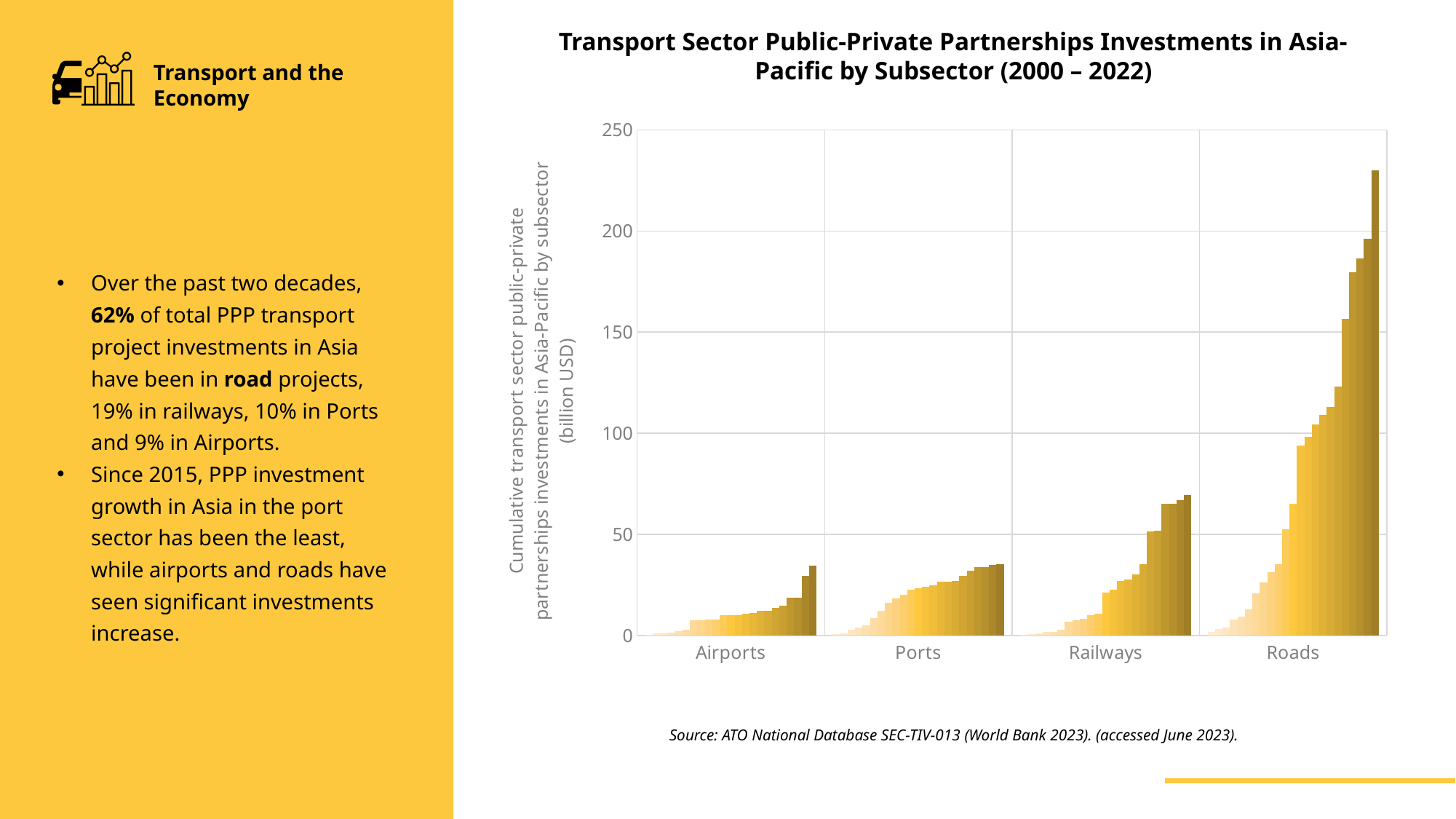
What unit is given in the y-axis label of the chart? billion USD Which is larger, the tallest bar for Roads or the tallest bar for Railways? Roads Is the tallest bar for Airports greater or less than 50? less How many subsector categories are shown on the x axis of the chart? 4 What kind of chart is shown on the slide? Bar chart Is the tallest bar for Roads greater or less than 200? greater What is the title of the chart? Transport Sector Public-Private Partnerships Investments in Asia-Pacific by Subsector (2000 – 2022) Is the tallest bar for Railways greater or less than 100? less Which subsector has the highest cumulative PPP investment in the chart? Roads Within each subsector group, do the bars rise or fall from left to right? Rise